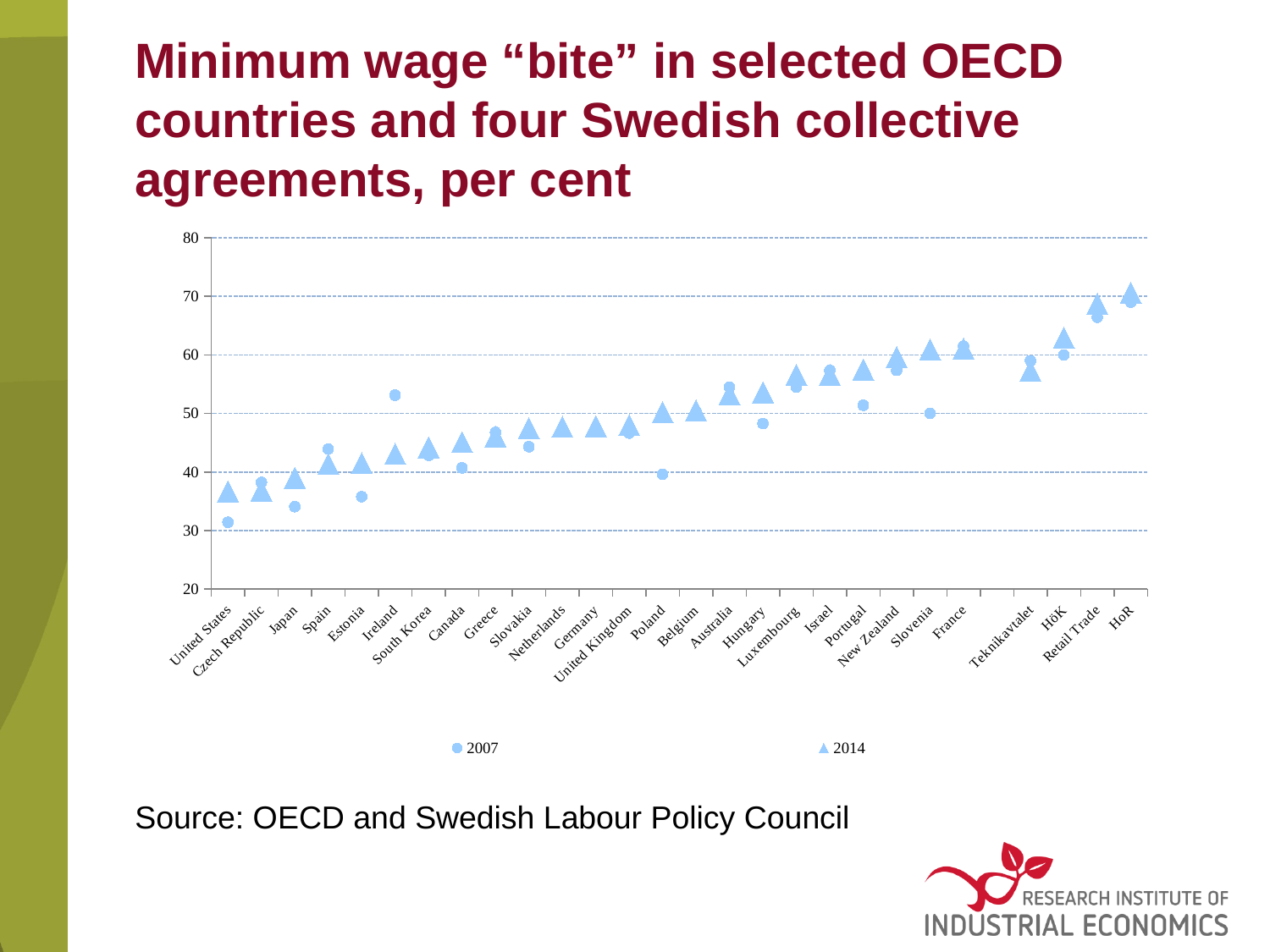
Is the 2007 value for Japan greater or less than 40? less Is the 2007 value for Ireland greater or less than 50? greater Which two years are shown in the legend? 2007 and 2014 For Ireland, which is larger: the 2007 value or the 2014 value? 2007 Is the 2014 value for HöK greater or less than 60? greater How many categories are plotted along the x axis? 27 For Slovenia, which is larger: the 2007 value or the 2014 value? 2014 What kind of chart is shown on the slide? Scatter (dot) chart Do the 2014 values generally rise or fall moving from left to right along the x axis? Rise How many series does the legend list? 2